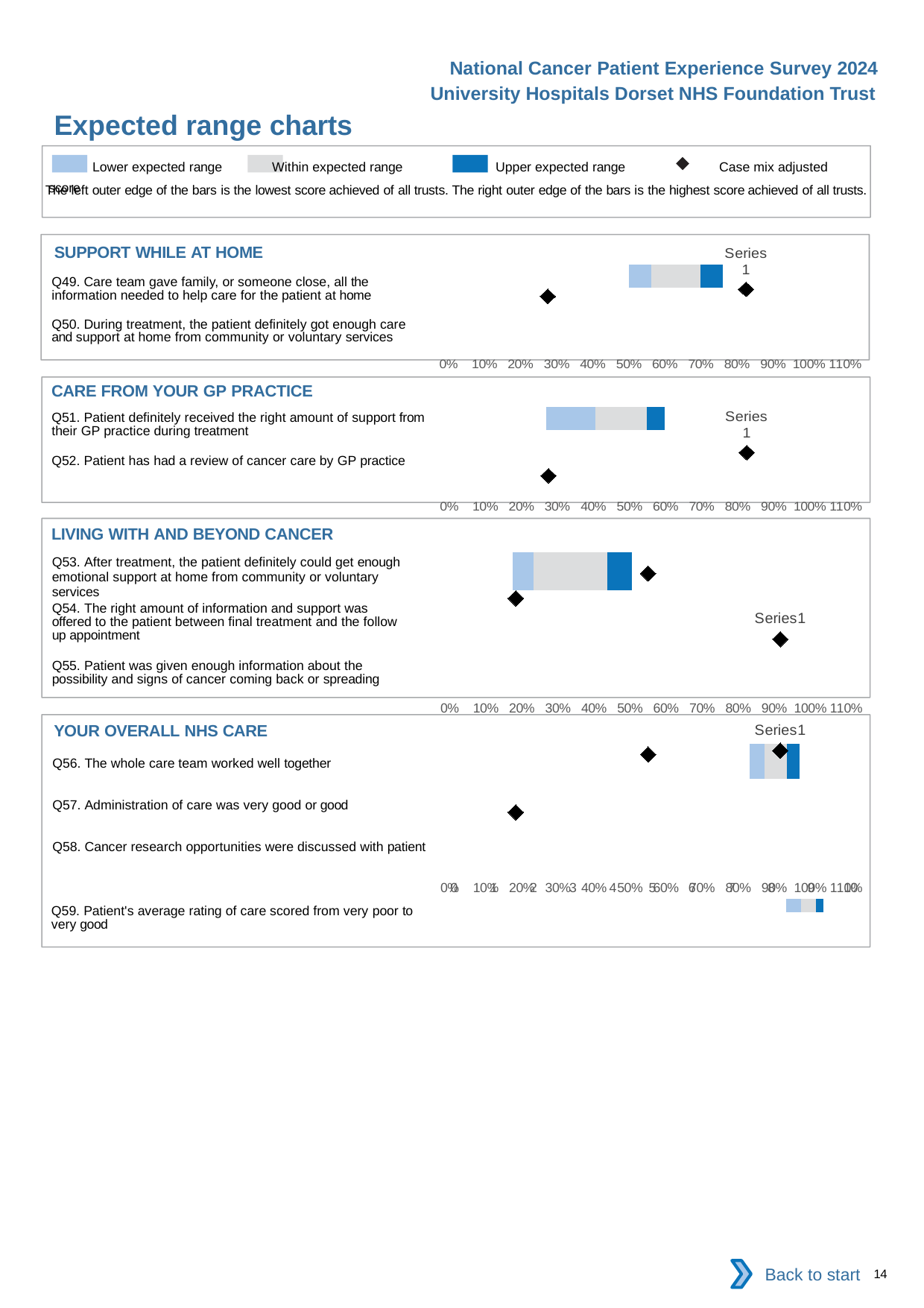
What kind of chart is used in the expected range charts on this slide? bar chart How many questions are listed in the YOUR OVERALL NHS CARE chart? 4 What is the title of the slide's charts? Expected range charts How many questions are listed in the SUPPORT WHILE AT HOME chart? 2 How many chart sections are shown on the slide? 4 In the SUPPORT WHILE AT HOME chart, is the left edge of the expected range bar greater or less than 40%? greater Which chart section has an expected range bar that extends furthest to the right on the axis? YOUR OVERALL NHS CARE In the CARE FROM YOUR GP PRACTICE chart, is the right edge of the expected range bar greater or less than 70%? less Which legend entry is shown with a black diamond marker? Case mix adjusted score In the LIVING WITH AND BEYOND CANCER chart, is the left edge of the expected range bar greater or less than 30%? less How many entries does the legend at the top of the slide list? 4